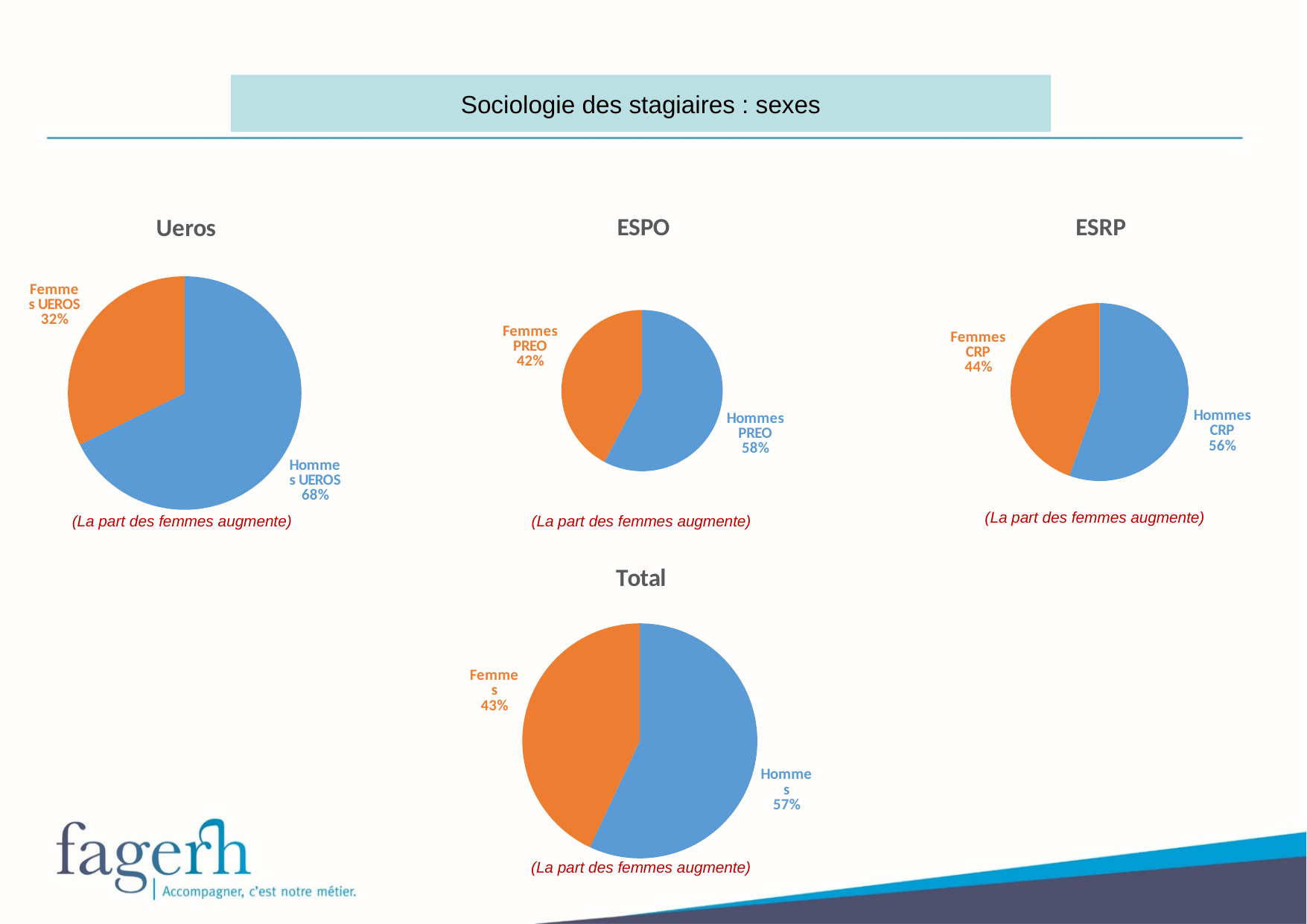
In the ESRP pie chart, what is the difference in percentage points between Hommes CRP and Femmes CRP? 12 What type of chart is the Total chart? Pie chart In the Total pie chart, which slice is larger, Femmes or Hommes? Hommes In the Ueros pie chart, what share is labelled for Femmes UEROS? 32% In the ESPO pie chart, what share is labelled for Femmes PREO? 42% How many slices does the ESPO pie chart have? 2 In the Total pie chart, what share is labelled for Femmes? 43% In the ESRP pie chart, what share is labelled for Hommes CRP? 56% In the ESPO pie chart, what colour is the Femmes PREO slice? Orange How many pie charts are shown on the slide? 4 In the Ueros pie chart, what is the difference in percentage points between Hommes UEROS and Femmes UEROS? 36 In the Ueros pie chart, what share is labelled for Hommes UEROS? 68%